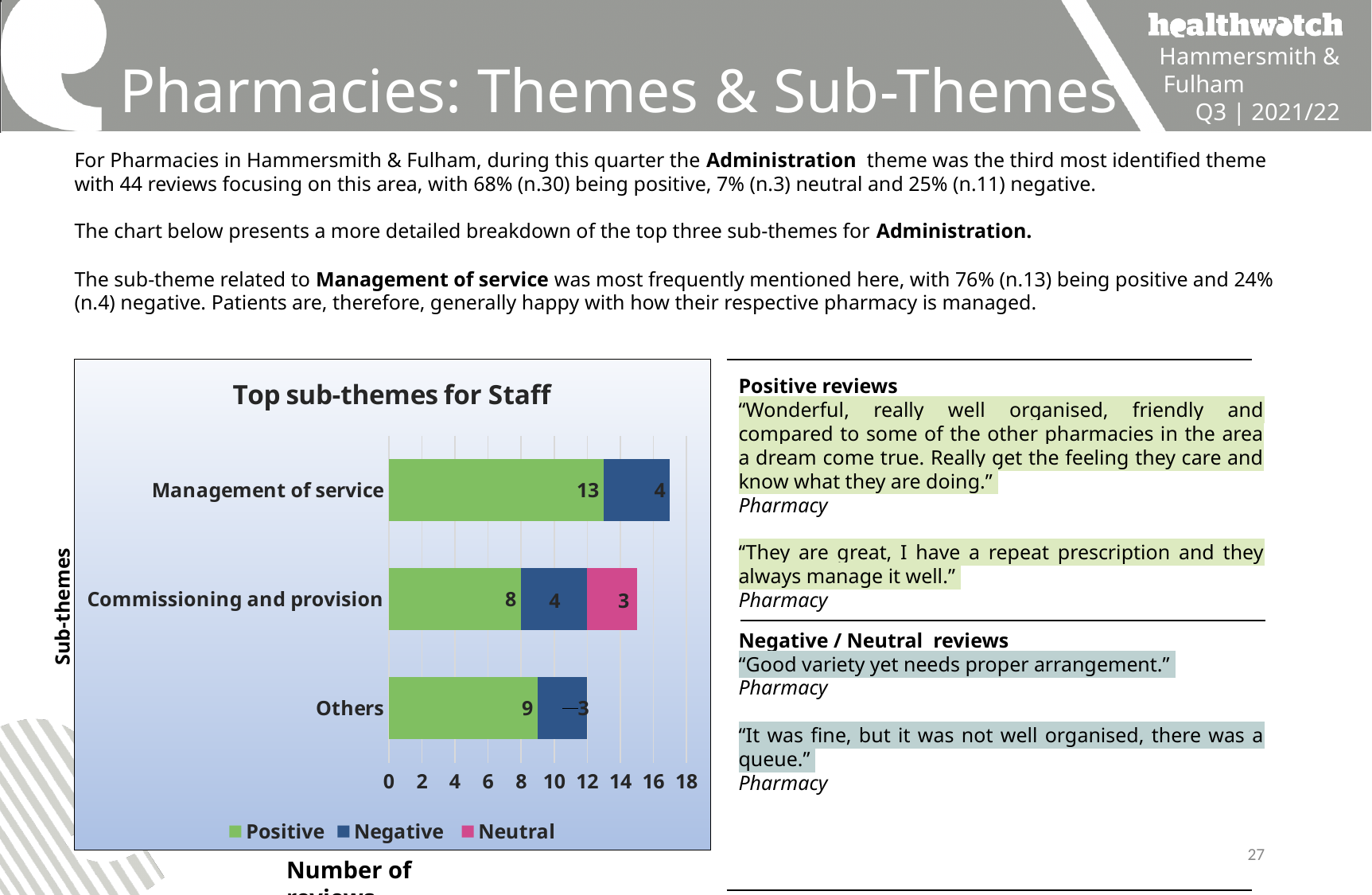
What is the Negative value for Commissioning and provision? 4 What is the difference between the Positive values for Management of service and Commissioning and provision? 5 What is the total number of reviews for the Commissioning and provision bar? 15 Which sub-theme has the highest Positive value? Management of service What is the Positive value for Others? 9 How many sub-theme categories are plotted in the chart? 3 What kind of chart is shown on the slide? Stacked bar chart How many series does the chart legend list? 3 What is the title of the chart? Top sub-themes for Staff What is the Neutral value for Commissioning and provision? 3 What is the Positive value for Management of service? 13 Which is larger: the Negative value for Management of service or the Negative value for Others? Management of service